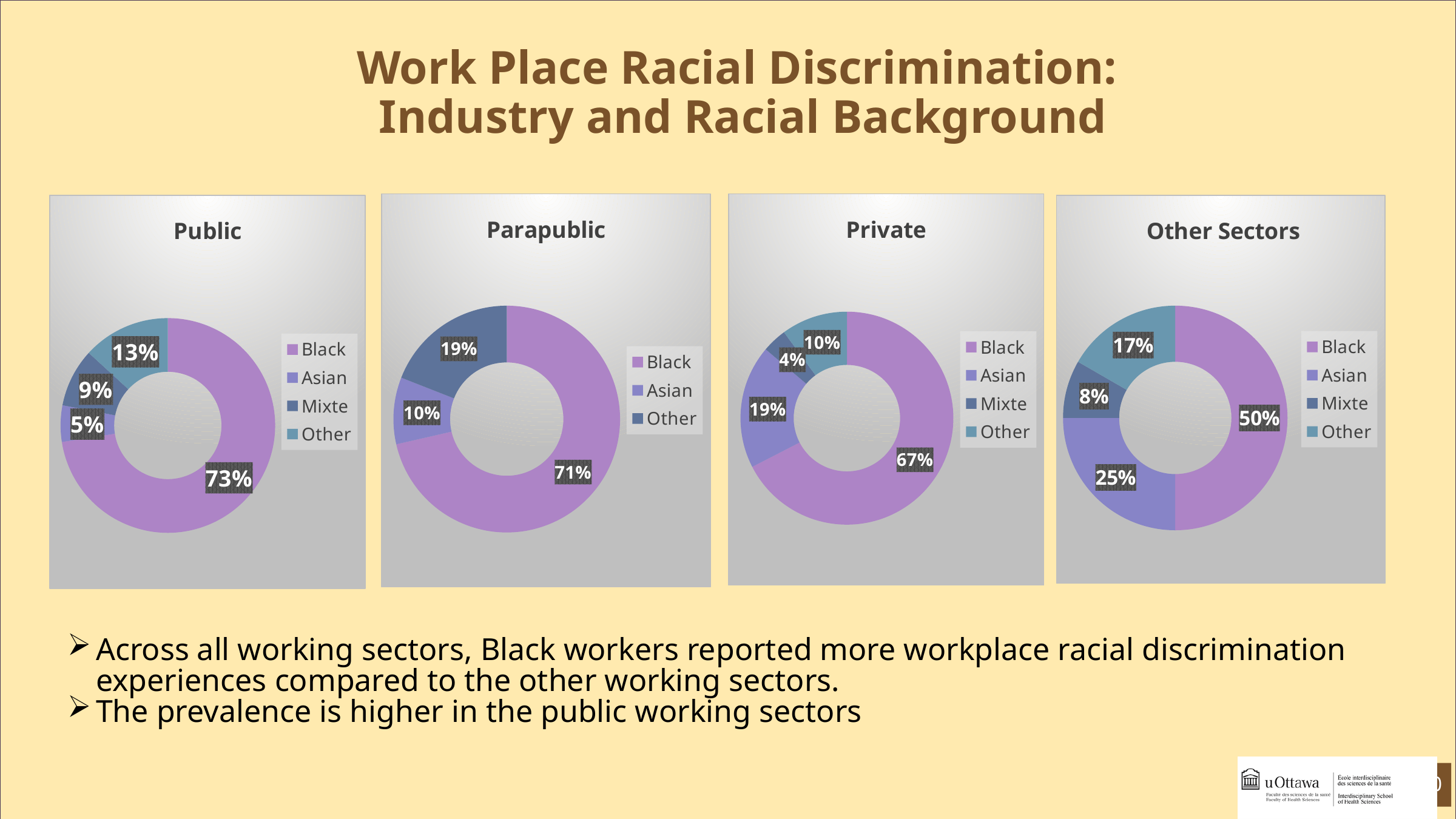
How many categories are shown in the Private chart? 4 What colour represents Black in the Public chart? Purple In the Public chart, what percentage is shown for Black? 73% In the Other Sectors chart, what percentage is shown for Asian? 25% In the Other Sectors chart, which category has the largest share? Black In the Public chart, which is larger, the share for Mixte or the share for Other? Other How many legend entries does the Parapublic chart list? 3 In the Private chart, what is the difference between the Asian share and the Other share? 9% In the Public chart, which category has the smallest share? Asian What kind of chart is the Other Sectors chart? Doughnut (pie) chart In the Parapublic chart, what percentage is shown for Other? 19% In the Private chart, what percentage is shown for Mixte? 4%